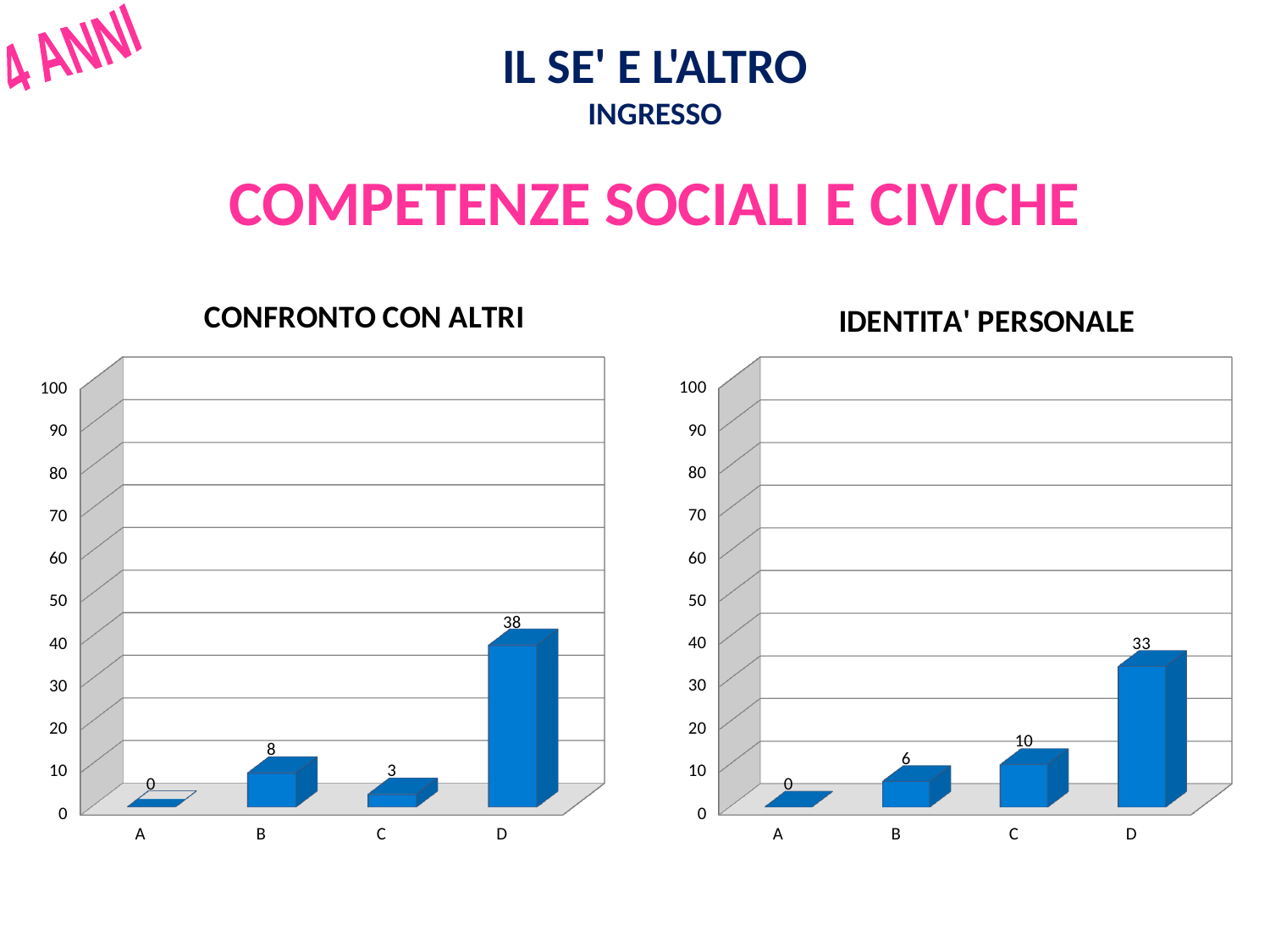
In the CONFRONTO CON ALTRI chart, which is larger, the value for B or the value for C? B In the CONFRONTO CON ALTRI chart, what is the value for B? 8 In the IDENTITA' PERSONALE chart, what is the difference between the values for C and B? 4 What is the title of the chart on the right side of the slide? IDENTITA' PERSONALE In the CONFRONTO CON ALTRI chart, which category has the highest value? D What kind of chart is the CONFRONTO CON ALTRI chart? Bar chart In the CONFRONTO CON ALTRI chart, what is the difference between the values for D and B? 30 How many categories are shown in the IDENTITA' PERSONALE chart? 4 In the IDENTITA' PERSONALE chart, which category has the lowest value? A In the IDENTITA' PERSONALE chart, what is the value for D? 33 In the IDENTITA' PERSONALE chart, what is the value for C? 10 In the CONFRONTO CON ALTRI chart, what is the value for D? 38